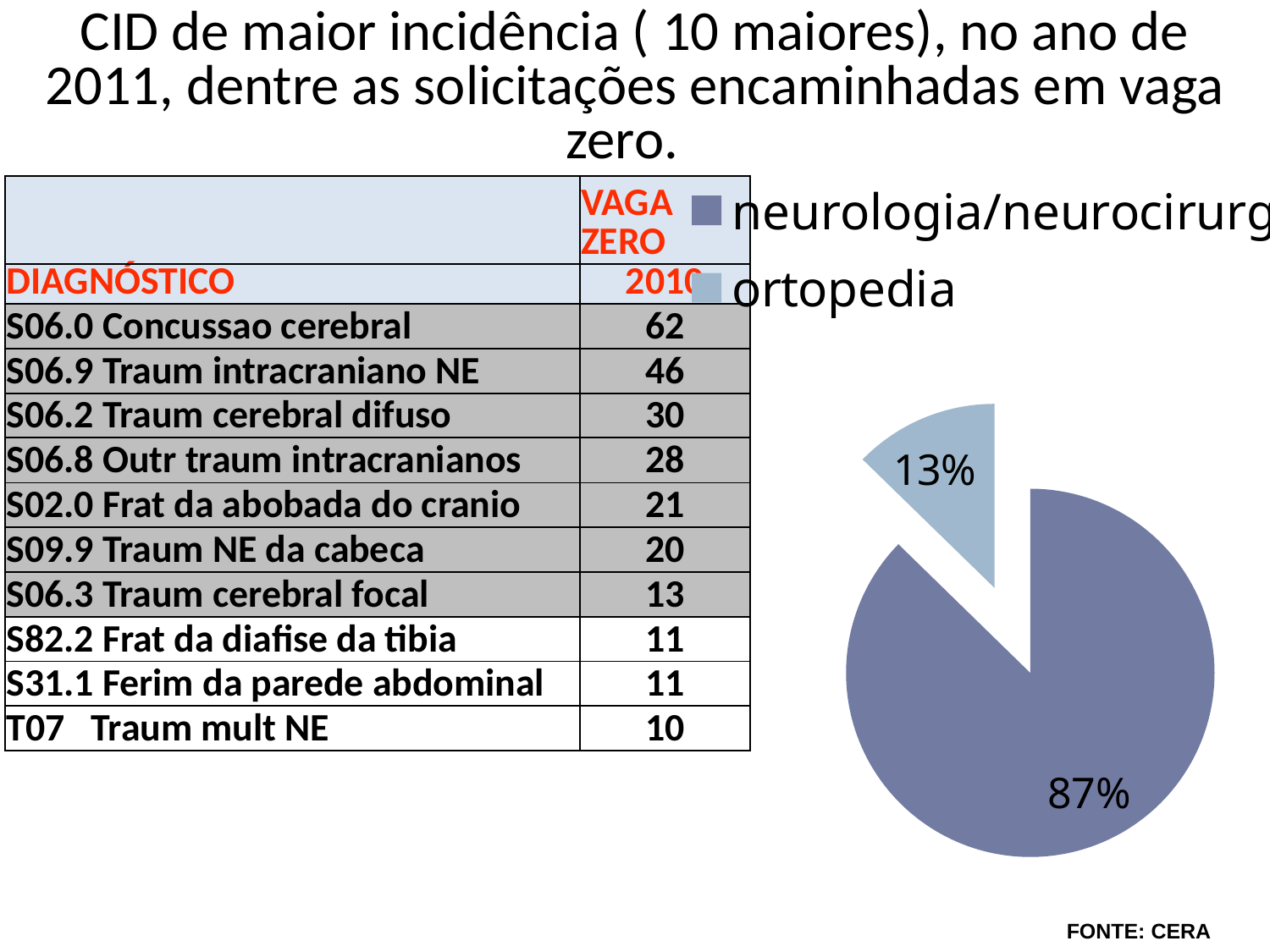
What share of the pie chart does the neurologia/neurocirurgia slice represent? 87% How many entries does the pie chart's legend list? 2 What colour is the ortopedia slice in the pie chart? light blue Is the ortopedia share of the pie chart greater or less than 50%? less Which is larger in the pie chart, ortopedia or neurologia/neurocirurgia? neurologia/neurocirurgia By how many percentage points does the neurologia/neurocirurgia slice exceed the ortopedia slice? 74 percentage points What kind of chart is shown on the right of the slide? pie chart What do the two slices of the pie chart add up to? 100% Which category has the largest slice in the pie chart? neurologia/neurocirurgia Which category has the smallest slice in the pie chart? ortopedia How many slices does the pie chart have? 2 What share of the pie chart does ortopedia represent? 13%